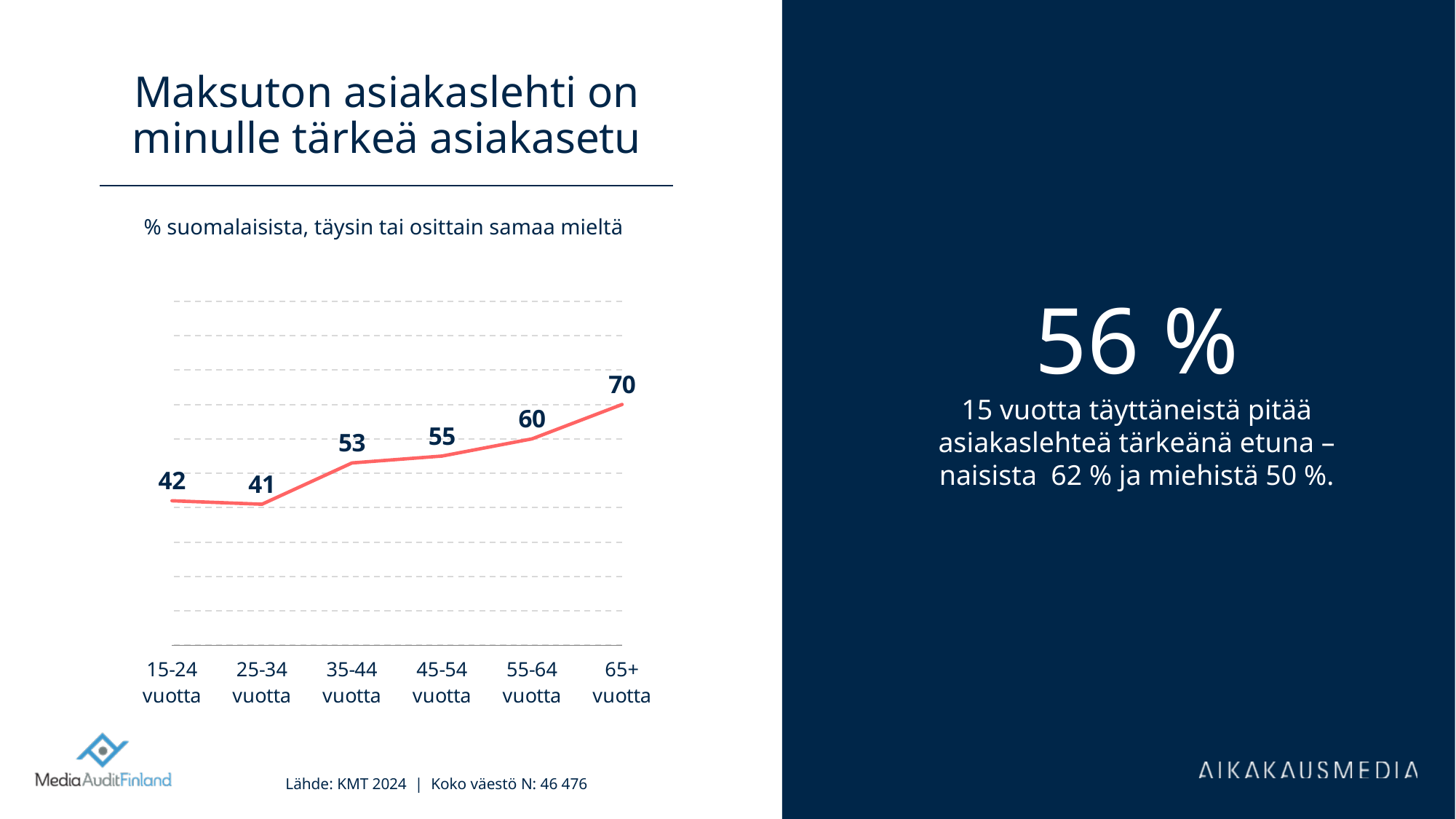
Which age group has the highest value? 65+ vuotta What is the difference between the values for 55-64 vuotta and 45-54 vuotta? 5 Which is larger, the value for 35-44 vuotta or the value for 45-54 vuotta? 45-54 vuotta Which age group has the lowest value? 25-34 vuotta What is the value for the 25-34 vuotta age group? 41 What kind of chart is shown on the slide? Line chart What is the difference between the values for 65+ vuotta and 15-24 vuotta? 28 What is the title of the chart? Maksuton asiakaslehti on minulle tärkeä asiakasetu What is the value for the 65+ vuotta age group? 70 What is the value for the 35-44 vuotta age group? 53 Do the values generally rise or fall from the youngest to the oldest age group? Rise How many age groups are plotted on the chart? 6